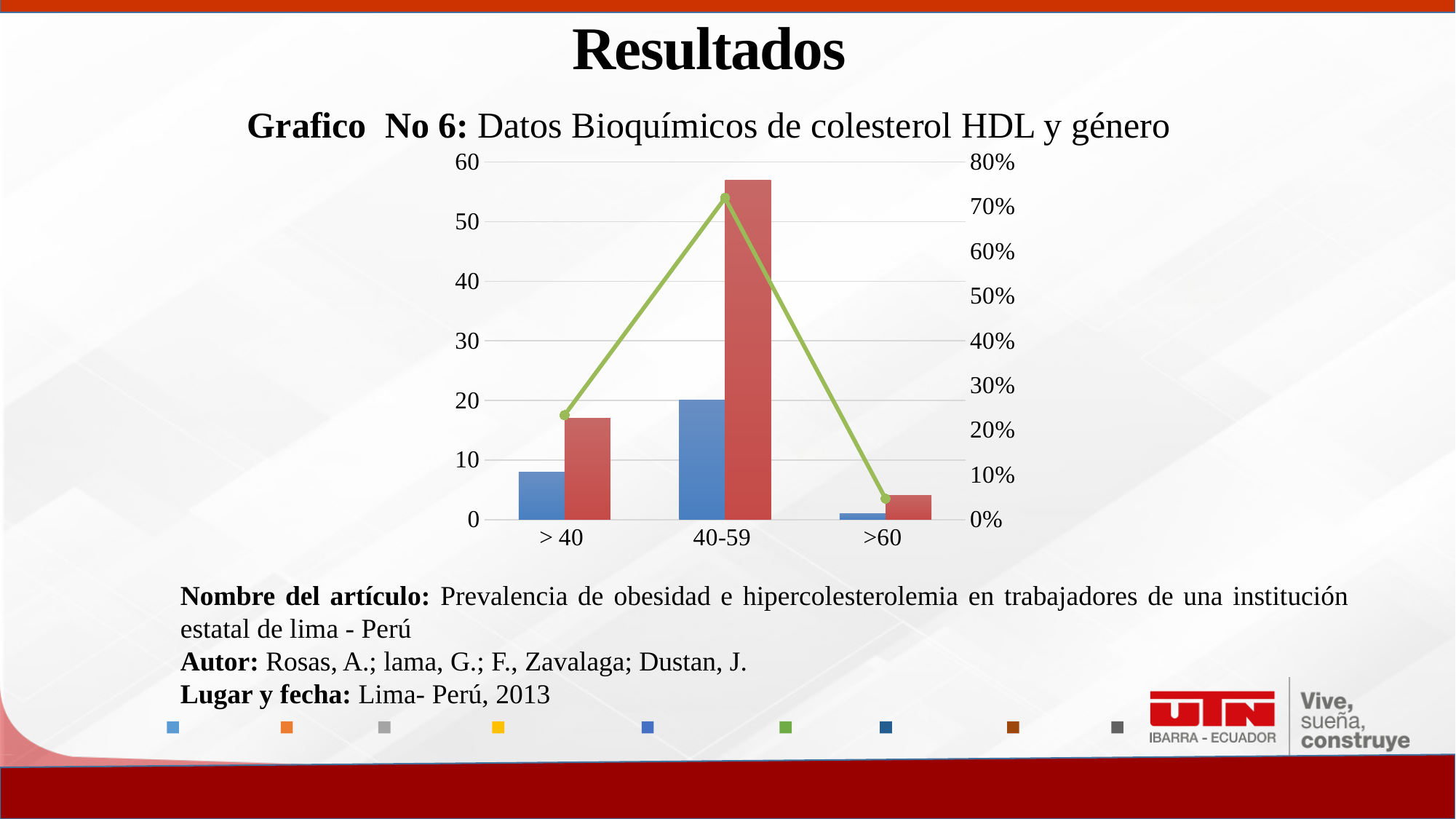
Is the red bar for 40-59 greater or less than 50? greater Does the green line rise or fall from 40-59 to >60? Fall Is the blue bar for 40-59 greater or less than 30? less Is the red bar for > 40 greater or less than 10? greater Which category has the tallest red bar? 40-59 Which category has the shortest blue bar? >60 In the > 40 category, which bar is taller, the blue bar or the red bar? The red bar What is the title of the chart? Grafico No 6: Datos Bioquímicos de colesterol HDL y género What kind of chart is shown on the slide? Bar chart with a line How many categories are shown on the x axis of the chart? 3